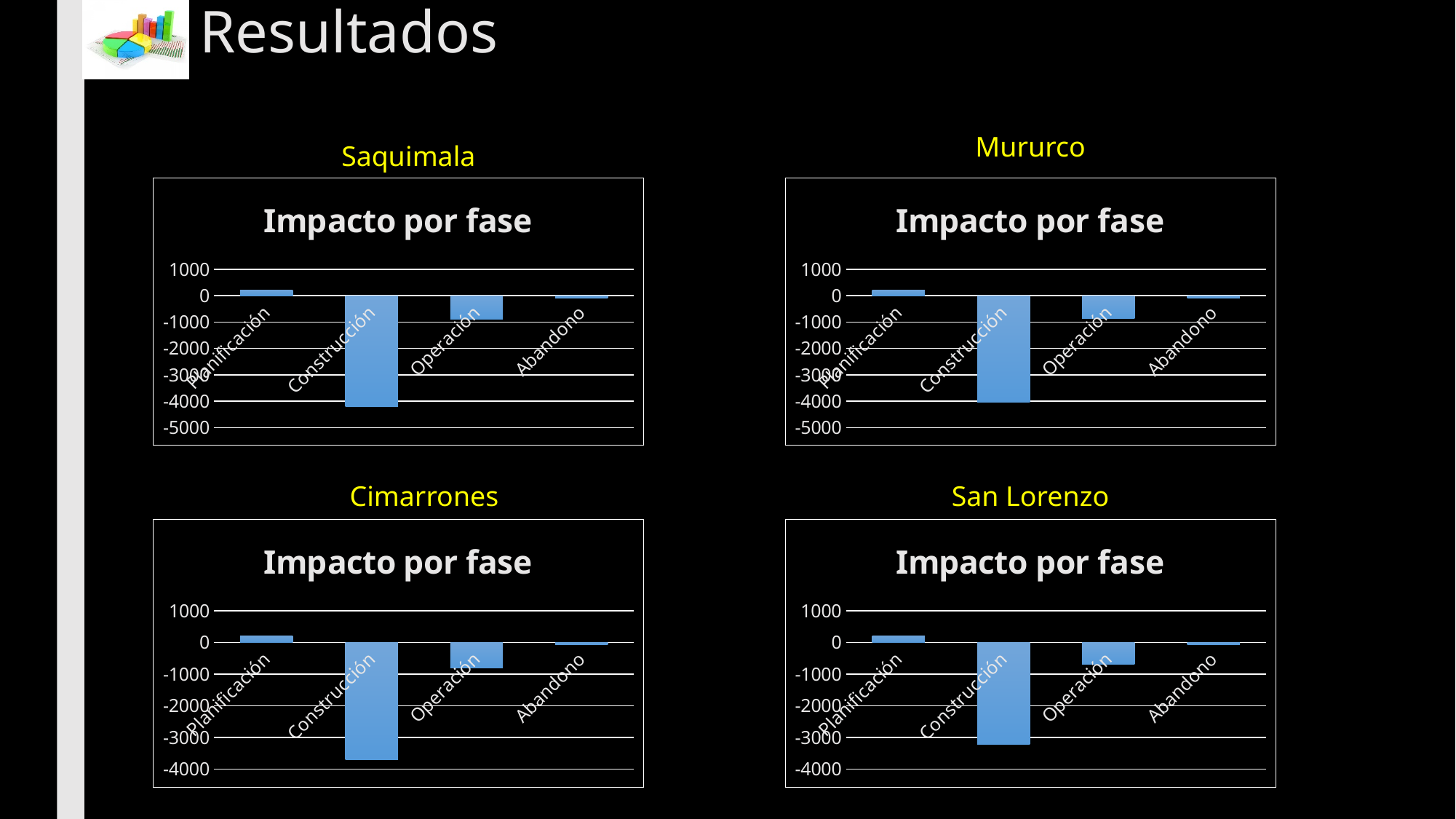
In the Saquimala chart, which phase has the lowest value? Construcción What is the lowest tick value on the y axis of the Saquimala chart? -5000 In the Cimarrones chart, is the value for Construcción greater or less than -3000? less In the Saquimala chart, is the value for Construcción greater or less than -4000? less In the Saquimala chart, which is larger, the value for Operación or the value for Abandono? Abandono What is the title shown inside the Mururco chart? Impacto por fase How many phases are shown on the x axis of the San Lorenzo chart? 4 What kind of chart is the Cimarrones chart? bar chart In the San Lorenzo chart, is the value for Construcción greater or less than -4000? greater In the Mururco chart, which phase has the highest value? Planificación